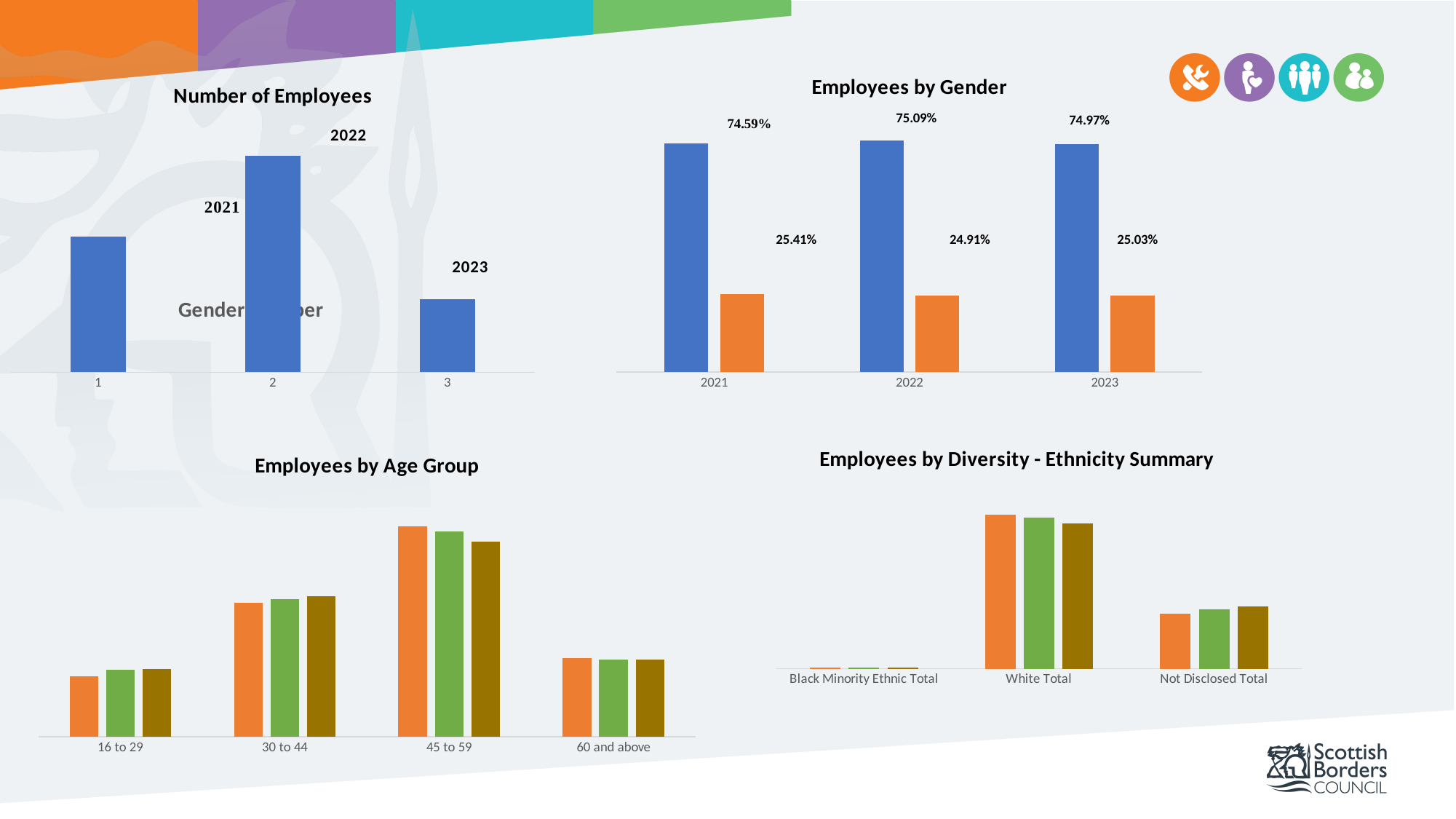
In the 'Employees by Gender' chart, what is the value of the orange bar for 2023? 25.03% In the 'Employees by Gender' chart, what is the value of the orange bar for 2022? 24.91% What type of chart is the 'Employees by Diversity - Ethnicity Summary' chart? bar chart In the 'Number of Employees' chart, which year has the shortest bar? 2023 In the 'Employees by Age Group' chart, which age group has the tallest bars? 45 to 59 In the 'Employees by Gender' chart, what is the difference between the blue and orange bar values for 2021? 49.18% In the 'Employees by Gender' chart, is the orange bar value for 2021 larger or smaller than the orange bar value for 2023? larger How many categories are shown on the x axis of the 'Employees by Age Group' chart? 4 In the 'Employees by Gender' chart, which year has the highest blue bar value? 2022 In the 'Employees by Diversity - Ethnicity Summary' chart, which category has the lowest bars? Black Minority Ethnic Total In the 'Employees by Gender' chart, what is the value of the blue bar for 2021? 74.59% In the 'Number of Employees' chart, which year has the tallest bar? 2022